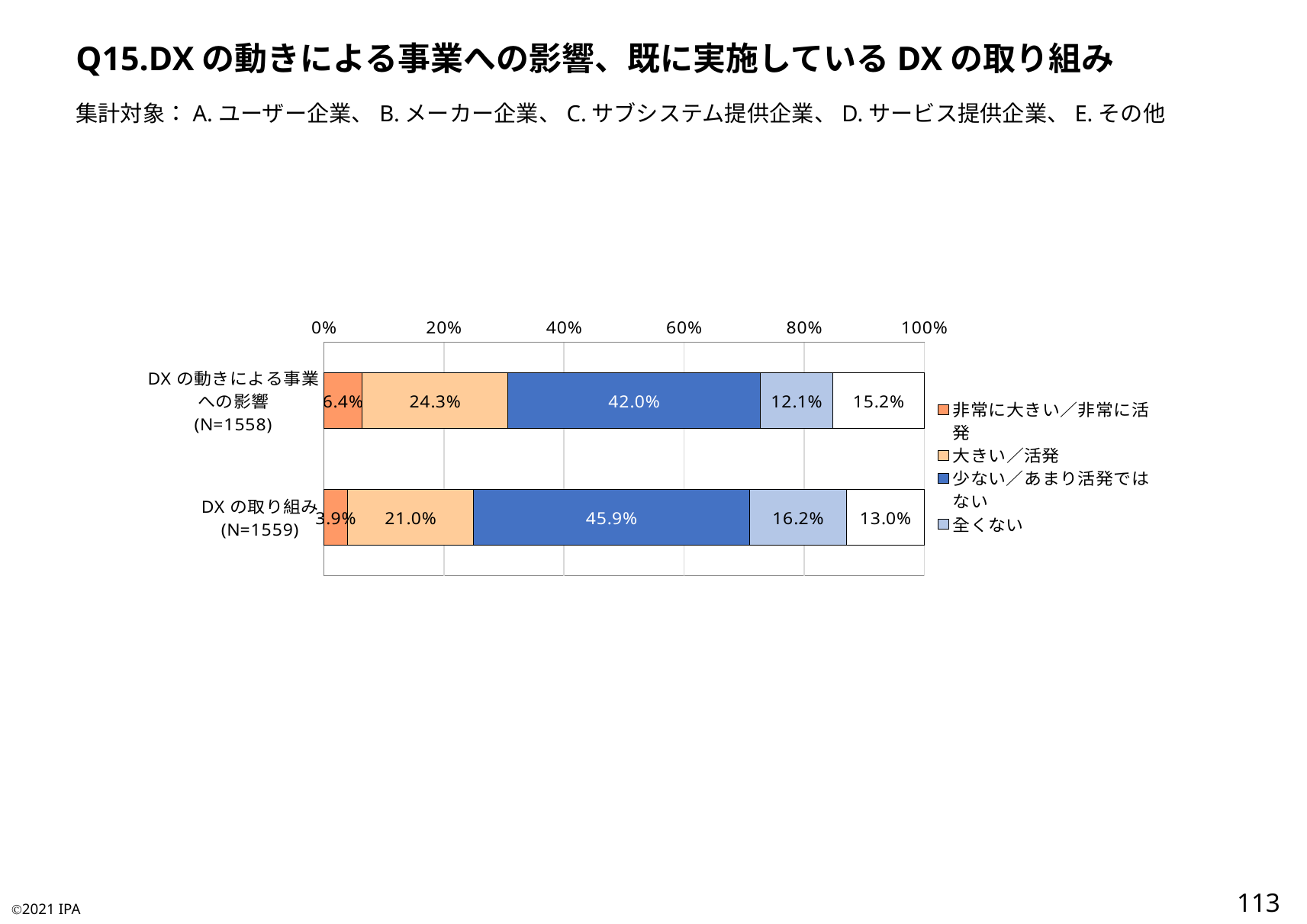
What is the difference between the 少ない／あまり活発ではない values for DXの取り組み and DXの動きによる事業への影響? 3.9 percentage points What is the value of the 全くない segment for DXの取り組み? 16.2% How many entries does the legend list? 4 What kind of chart is shown on the slide? Stacked horizontal bar chart What is the value of the 少ない／あまり活発ではない segment for DXの動きによる事業への影響 (N=1558)? 42.0% What is the value of the 大きい／活発 segment for DXの取り組み (N=1559)? 21.0% Which legend category has the largest segment in the DXの取り組み bar? 少ない／あまり活発ではない Which bar has the larger 大きい／活発 value, DXの動きによる事業への影響 or DXの取り組み? DXの動きによる事業への影響 Which legend category has the smallest segment in the DXの動きによる事業への影響 bar? 非常に大きい／非常に活発 What is the value of the 非常に大きい／非常に活発 segment for DXの動きによる事業への影響? 6.4% How many bars (categories) are plotted in the chart? 2 What is the N value shown for the DXの取り組み category? N=1559